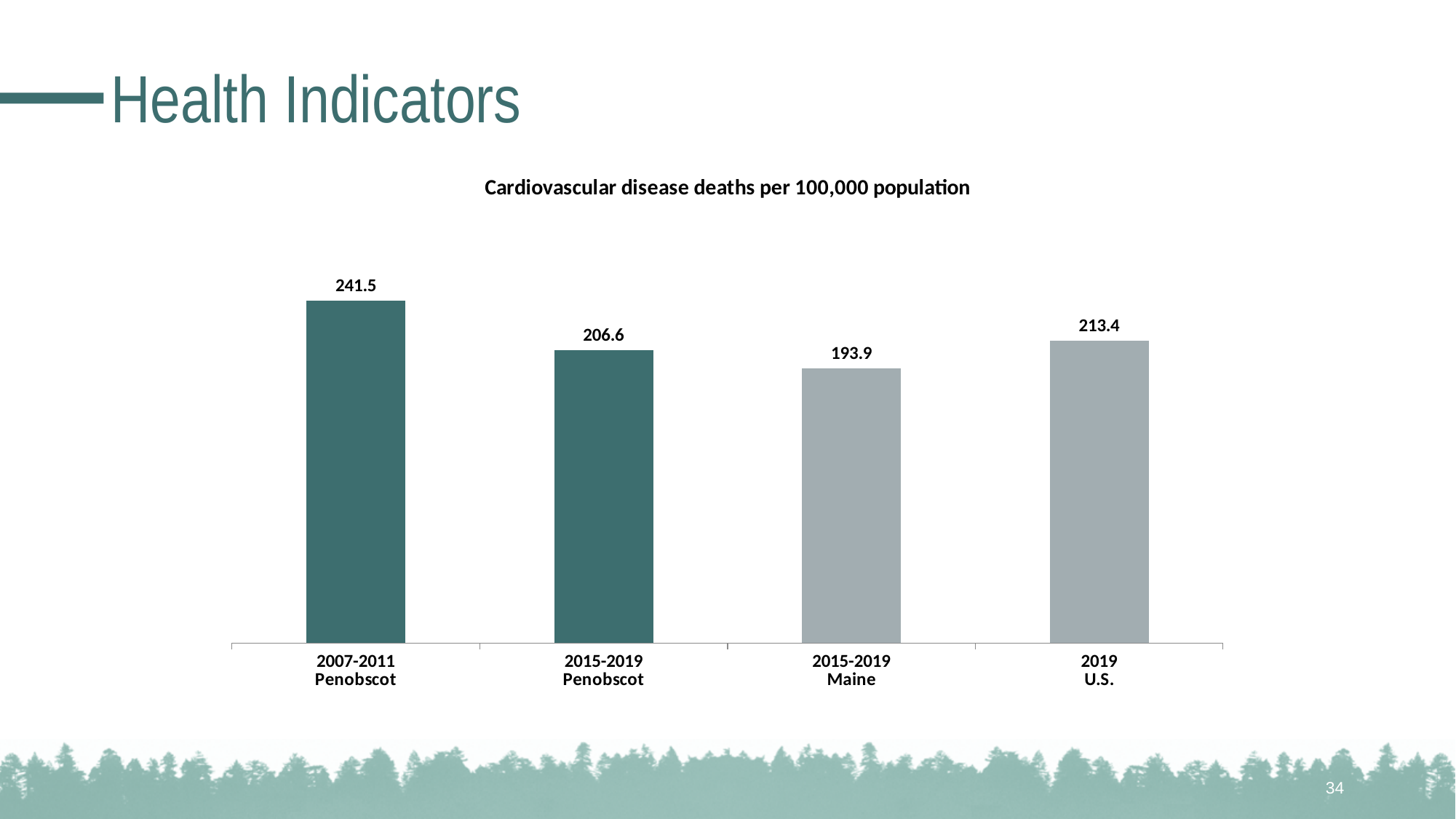
Which is larger, the value for 2015-2019 Penobscot or the value for 2019 U.S.? 2019 U.S. What is the difference between the 2007-2011 Penobscot value and the 2015-2019 Penobscot value? 34.9 What is the value for 2019 U.S.? 213.4 What kind of chart is shown on the slide? Bar chart What is the value for 2015-2019 Maine? 193.9 What is the value for 2015-2019 Penobscot? 206.6 Which category has the highest value? 2007-2011 Penobscot What is the value for 2007-2011 Penobscot? 241.5 Which category has the lowest value? 2015-2019 Maine How many categories are shown in the chart? 4 What is the title of the chart? Cardiovascular disease deaths per 100,000 population What is the difference between the 2019 U.S. value and the 2015-2019 Maine value? 19.5